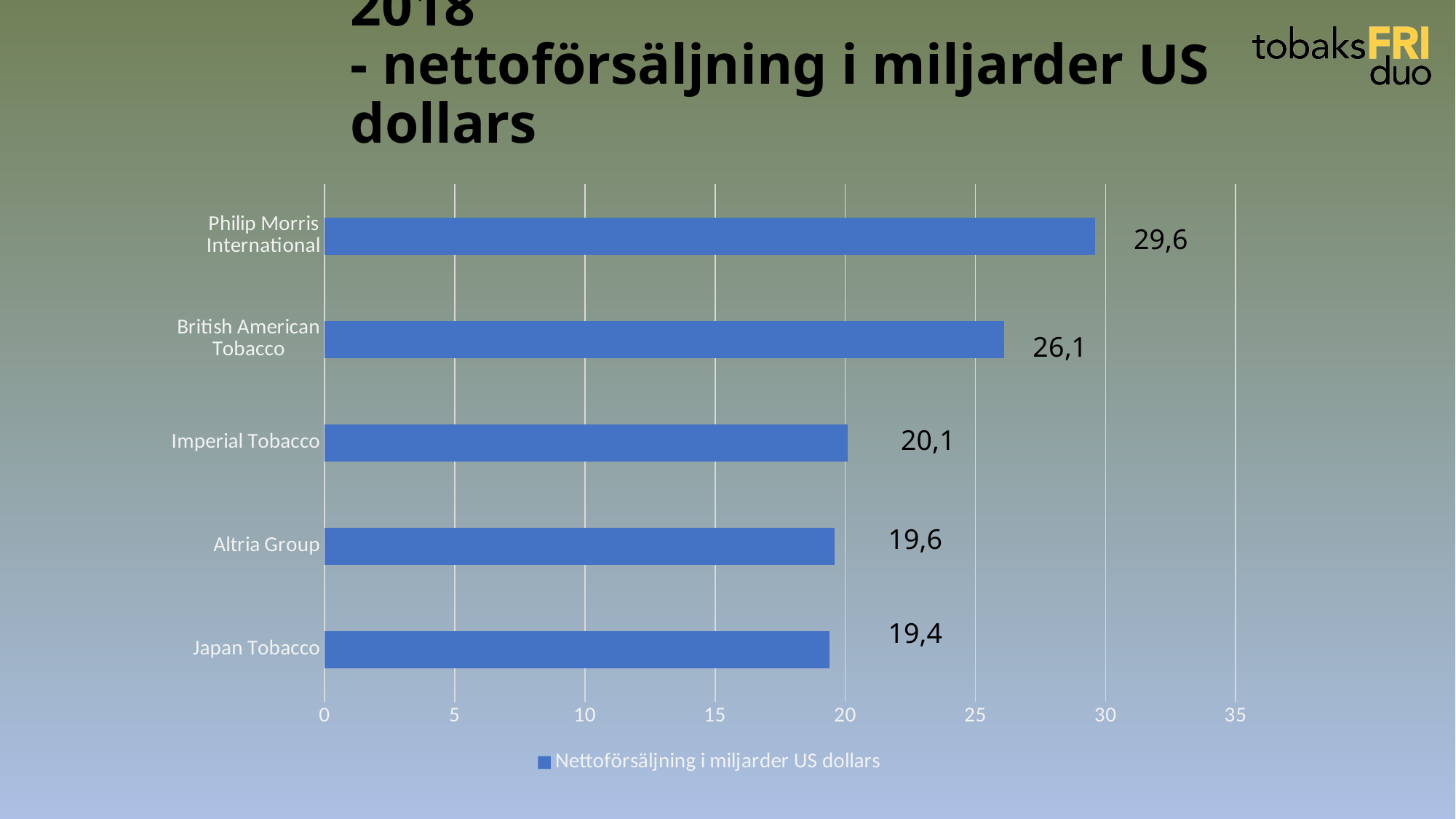
What is the net sales value shown for British American Tobacco? 26,1 What is the net sales value shown for Imperial Tobacco? 20,1 How many companies are shown in the chart? 5 Is the value for British American Tobacco greater or less than 25? greater What is the net sales value shown for Philip Morris International? 29,6 Which company has the highest net sales in the chart? Philip Morris International What is the net sales value shown for Japan Tobacco? 19,4 Which has higher net sales, Imperial Tobacco or Altria Group? Imperial Tobacco What kind of chart is shown on the slide? Bar chart What is the difference between the net sales of Philip Morris International and British American Tobacco? 3,5 What is the legend entry for the series in the chart? Nettoförsäljning i miljarder US dollars Which company has the lowest net sales in the chart? Japan Tobacco